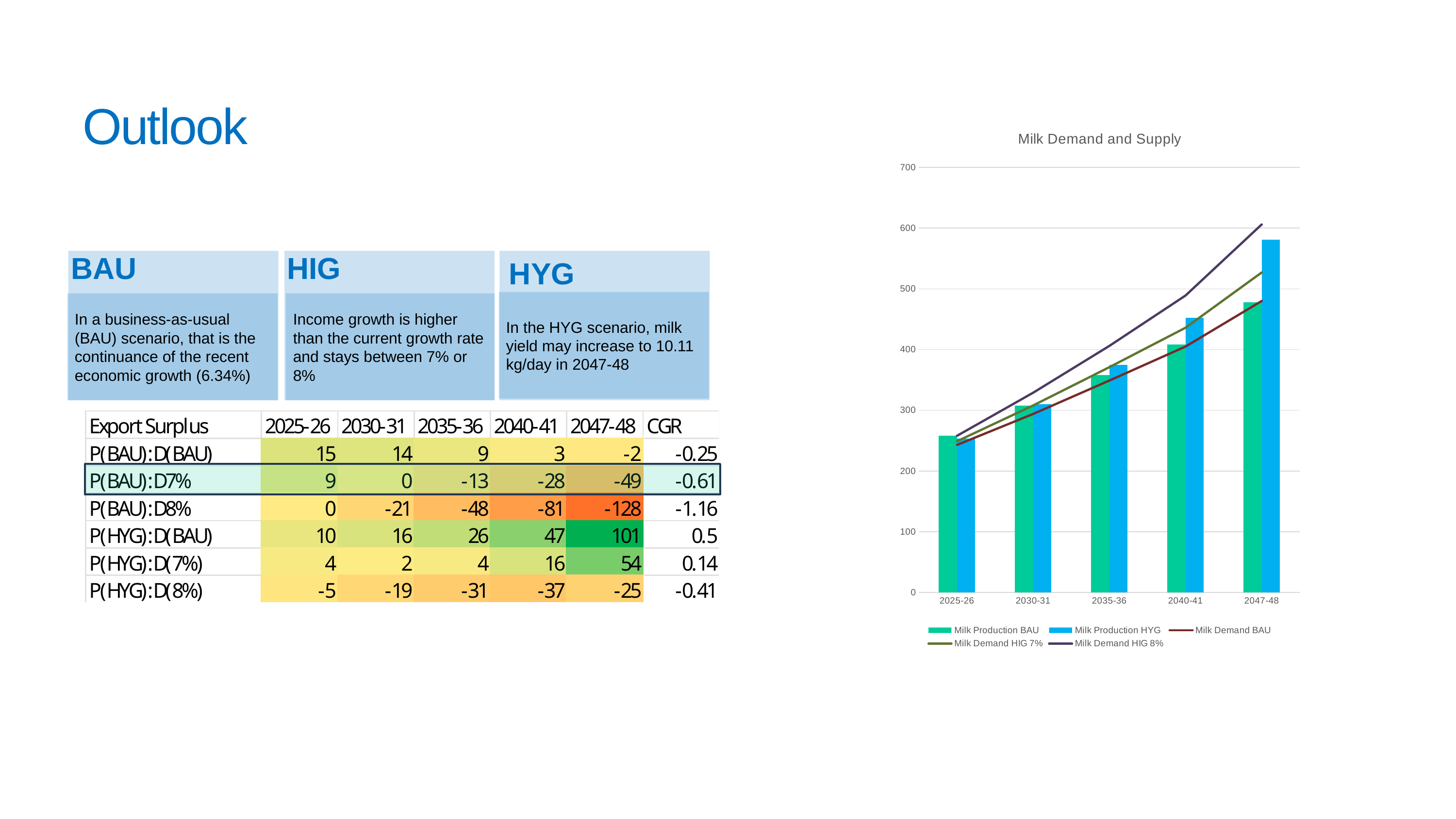
How many year categories are shown on the x axis of the Milk Demand and Supply chart? 5 What is the title of the chart on the right of the slide? Milk Demand and Supply How many series does the legend of the Milk Demand and Supply chart list? 5 In the Milk Demand and Supply chart, which is larger in 2047-48: Milk Demand HIG 8% or Milk Demand BAU? Milk Demand HIG 8% In the Milk Demand and Supply chart, is the Milk Production HYG value for 2047-48 greater or less than 500? greater What kind of chart is the Milk Demand and Supply chart? combination bar and line chart In the Milk Demand and Supply chart, is the Milk Production BAU value for 2035-36 greater or less than 300? greater In the Milk Demand and Supply chart, which year has the lowest Milk Production BAU bar? 2025-26 In the Milk Demand and Supply chart, is the Milk Production BAU value for 2025-26 greater or less than 300? less In the Milk Demand and Supply chart, which is larger in 2047-48: Milk Production HYG or Milk Production BAU? Milk Production HYG In the Milk Demand and Supply chart, do the Milk Production HYG bars rise or fall from 2025-26 to 2047-48? rise In the Milk Demand and Supply chart, which year has the highest Milk Production HYG bar? 2047-48